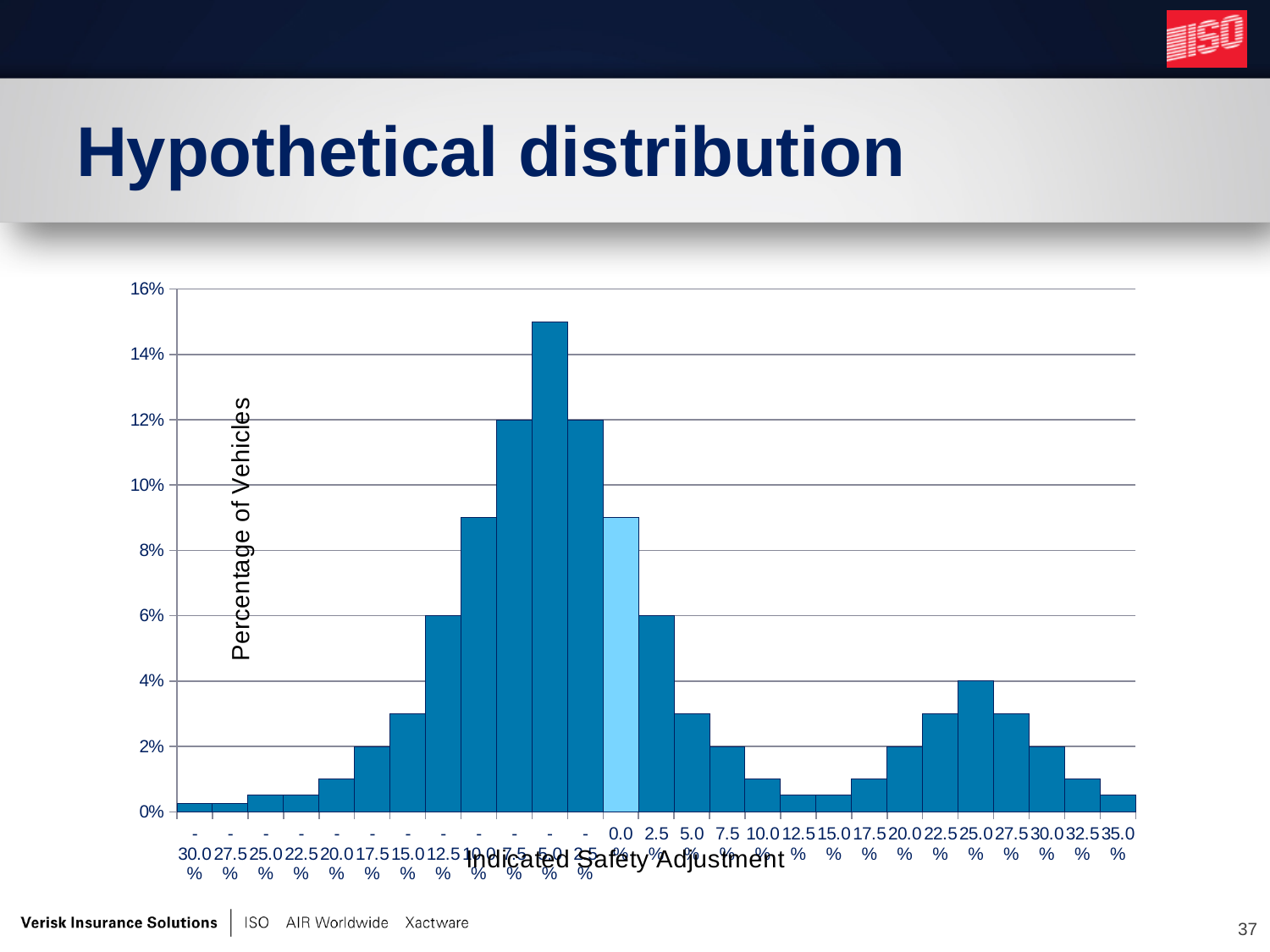
What is the Percentage of Vehicles for the 25.0% Indicated Safety Adjustment category? 4% What is the Percentage of Vehicles for the 2.5% Indicated Safety Adjustment category? 6% Is the Percentage of Vehicles for the -5.0% category greater or less than 14%? greater Which has a higher Percentage of Vehicles, the -5.0% category or the 25.0% category? -5.0% Do the values rise or fall along the x axis from the -5.0% category to the 12.5% category? fall What type of chart is shown on the slide? bar chart Which Indicated Safety Adjustment category has the highest Percentage of Vehicles? -5.0% What is the difference in Percentage of Vehicles between the -7.5% category and the -12.5% category? 6% What is the label of the vertical axis? Percentage of Vehicles What is the title of the chart on the slide? Hypothetical distribution Is the Percentage of Vehicles for the 0.0% category greater or less than 8%? greater What is the Percentage of Vehicles for the -7.5% Indicated Safety Adjustment category? 12%